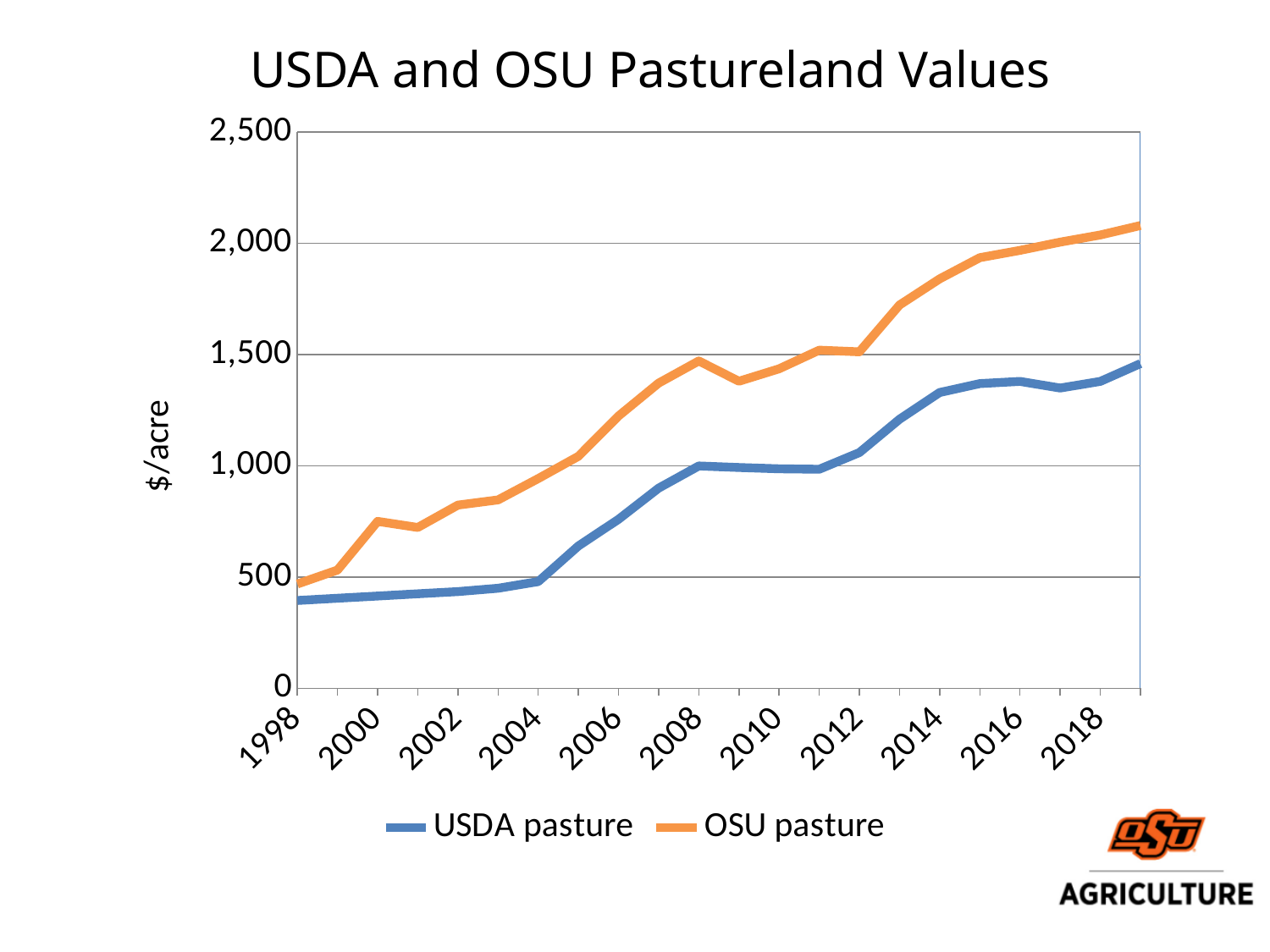
Is the value for USDA pasture in 2004 greater or less than 500? less Is the value for USDA pasture in 2016 greater or less than 1,500? less Do the USDA pasture values generally rise or fall from 1998 to 2018? Rise Is the value for OSU pasture in 2000 greater or less than 500? greater What is the label on the y axis? $/acre What is the title of the chart? USDA and OSU Pastureland Values Which series has the higher value in 2010, USDA pasture or OSU pasture? OSU pasture What kind of chart is shown on the slide? Line chart Which series has the higher value in 2018, USDA pasture or OSU pasture? OSU pasture How many series does the legend list? 2